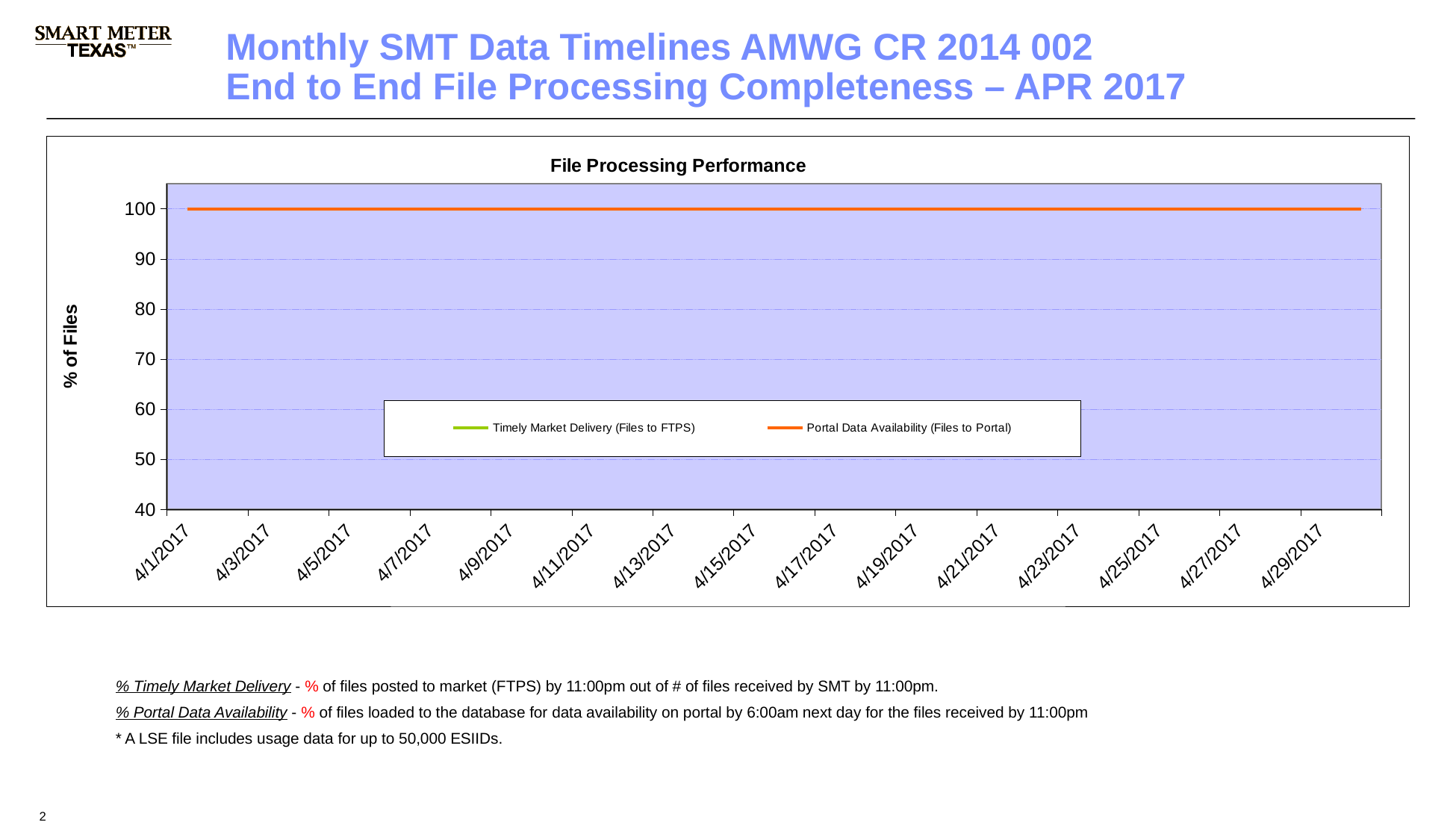
What kind of chart is shown on the slide? line chart Is the value for Portal Data Availability (Files to Portal) on 4/21/2017 greater or less than 90? greater What is the label of the vertical axis of the chart? % of Files Does the Portal Data Availability (Files to Portal) line rise, fall, or stay flat across April 2017? stays flat Is the value for Portal Data Availability (Files to Portal) on 4/9/2017 greater or less than 50? greater How many date labels are shown along the x axis of the chart? 15 What is the difference between the Portal Data Availability (Files to Portal) values on 4/1/2017 and 4/29/2017? 0 What is the title of the chart on the slide? File Processing Performance What value does the Portal Data Availability (Files to Portal) line show on 4/1/2017? 100 How many series does the legend of the File Processing Performance chart list? 2 What value does the Portal Data Availability (Files to Portal) line show on 4/15/2017? 100 What is the lowest value shown on the vertical axis of the chart? 40